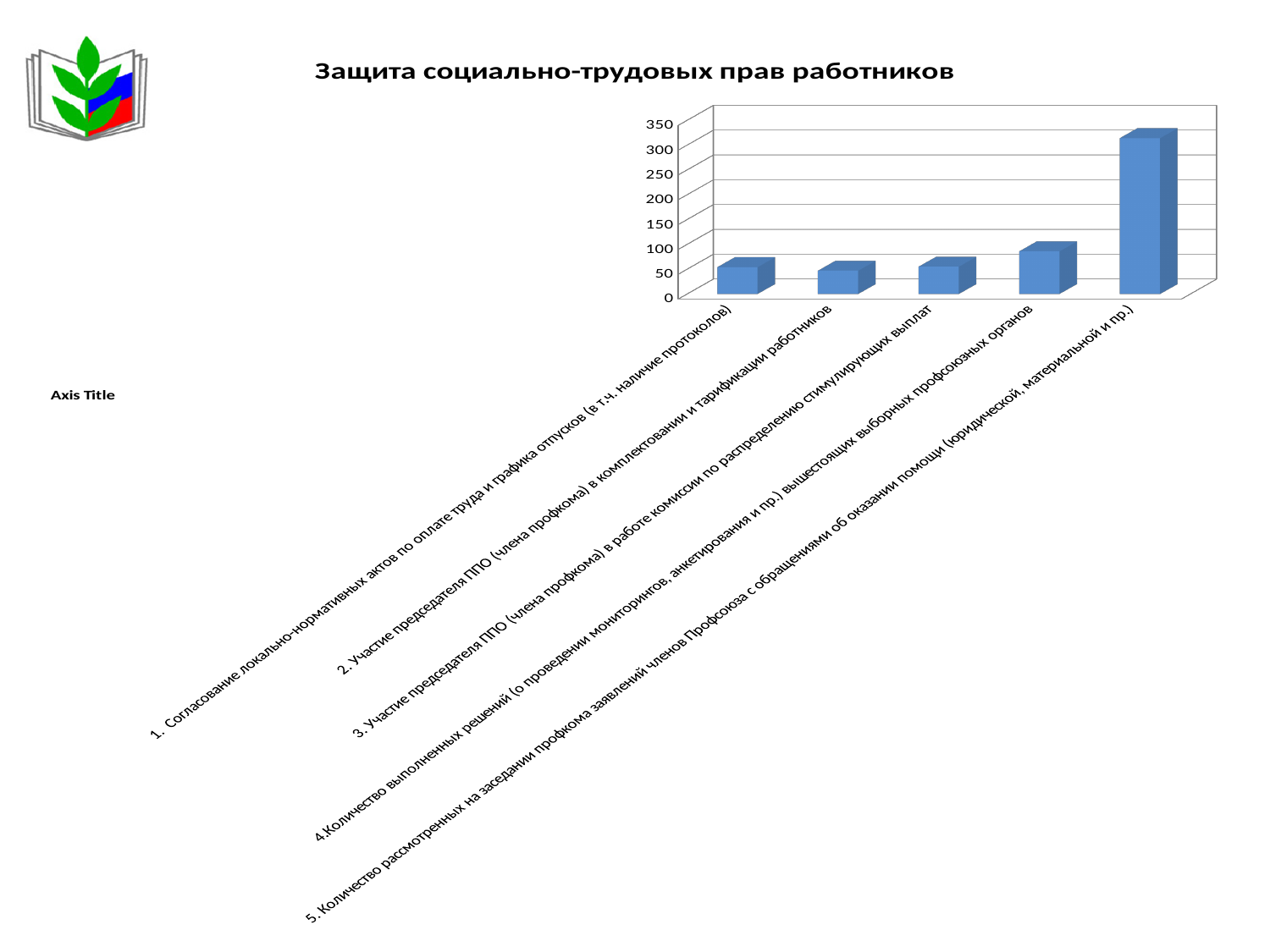
Which category has the highest value? 5. Количество рассмотренных на заседании профкома заявлений членов Профсоюза с обращениями об оказании помощи (юридической, материальной и пр.) Which is larger: the value for category 5 (Количество рассмотренных заявлений членов Профсоюза) or category 4 (Количество выполненных решений вышестоящих профсоюзных органов)? category 5 Is the value for category 5 (Количество рассмотренных на заседании профкома заявлений членов Профсоюза) greater or less than 250? greater Which is larger: the value for category 4 (Количество выполненных решений вышестоящих профсоюзных органов) or category 2 (Участие председателя ППО в комплектовании и тарификации работников)? category 4 What is the title of the chart? Защита социально-трудовых прав работников What is the highest tick value shown on the vertical axis? 350 What kind of chart is shown on the slide? bar chart Is the value for category 2 (Участие председателя ППО в комплектовании и тарификации работников) greater or less than 100? less Is the value for category 4 (Количество выполненных решений вышестоящих выборных профсоюзных органов) greater or less than 150? less How many categories (bars) does the chart show? 5